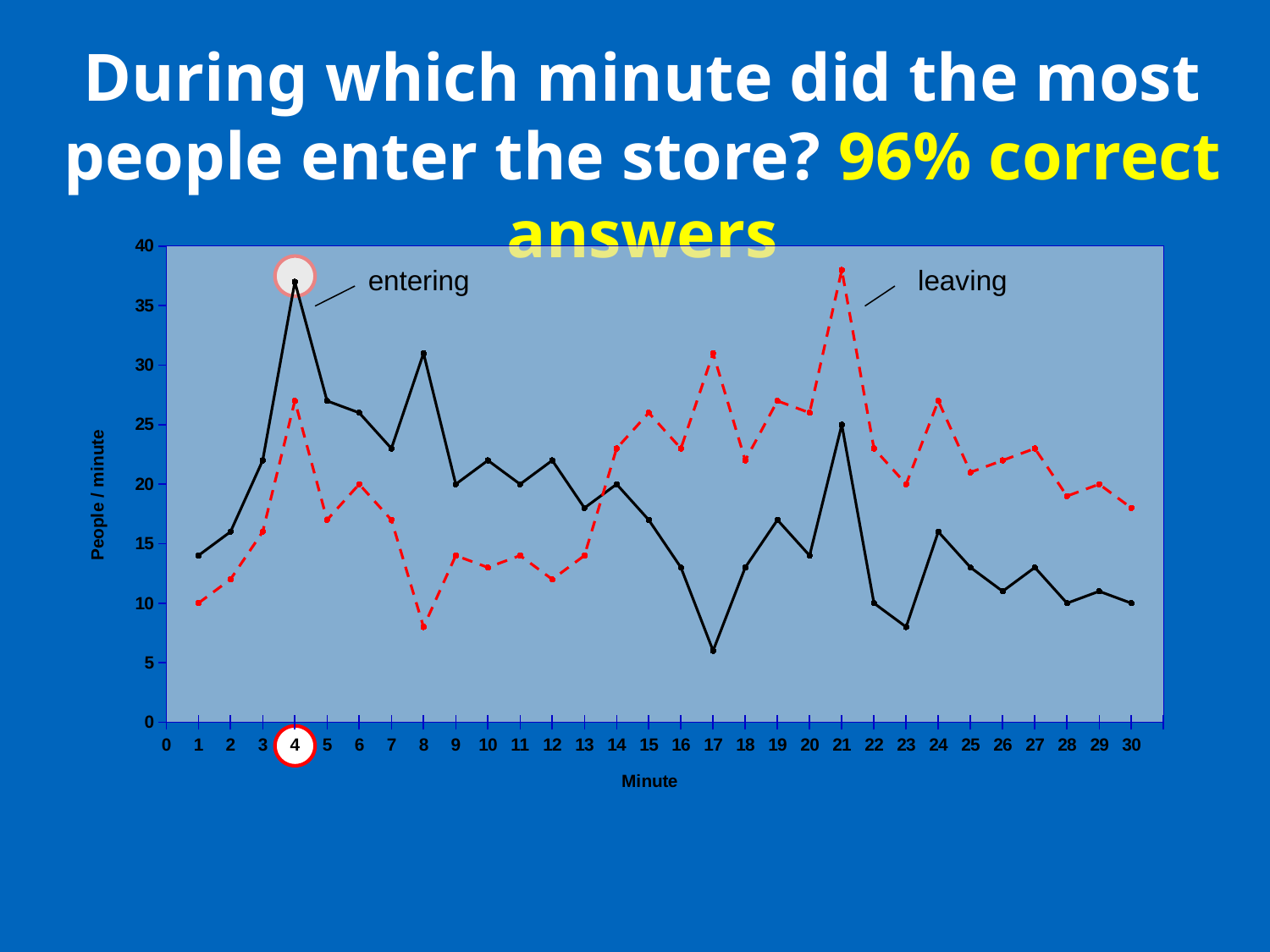
Is the entering value at minute 4 greater or less than 35? greater During which minute does the leaving series reach its highest value? 21 At minute 21, which series has the larger value, entering or leaving? leaving Is the entering value at minute 8 greater or less than 30? greater At minute 4, which series has the larger value, entering or leaving? entering How many series are plotted on the chart? 2 During which minute does the entering series reach its highest value? 4 Is the leaving value at minute 8 greater or less than 10? less What is the label on the vertical axis of the chart? People / minute During which minute does the entering series reach its lowest value? 17 During which minute does the leaving series reach its lowest value? 8 What kind of chart is shown on the slide? line chart